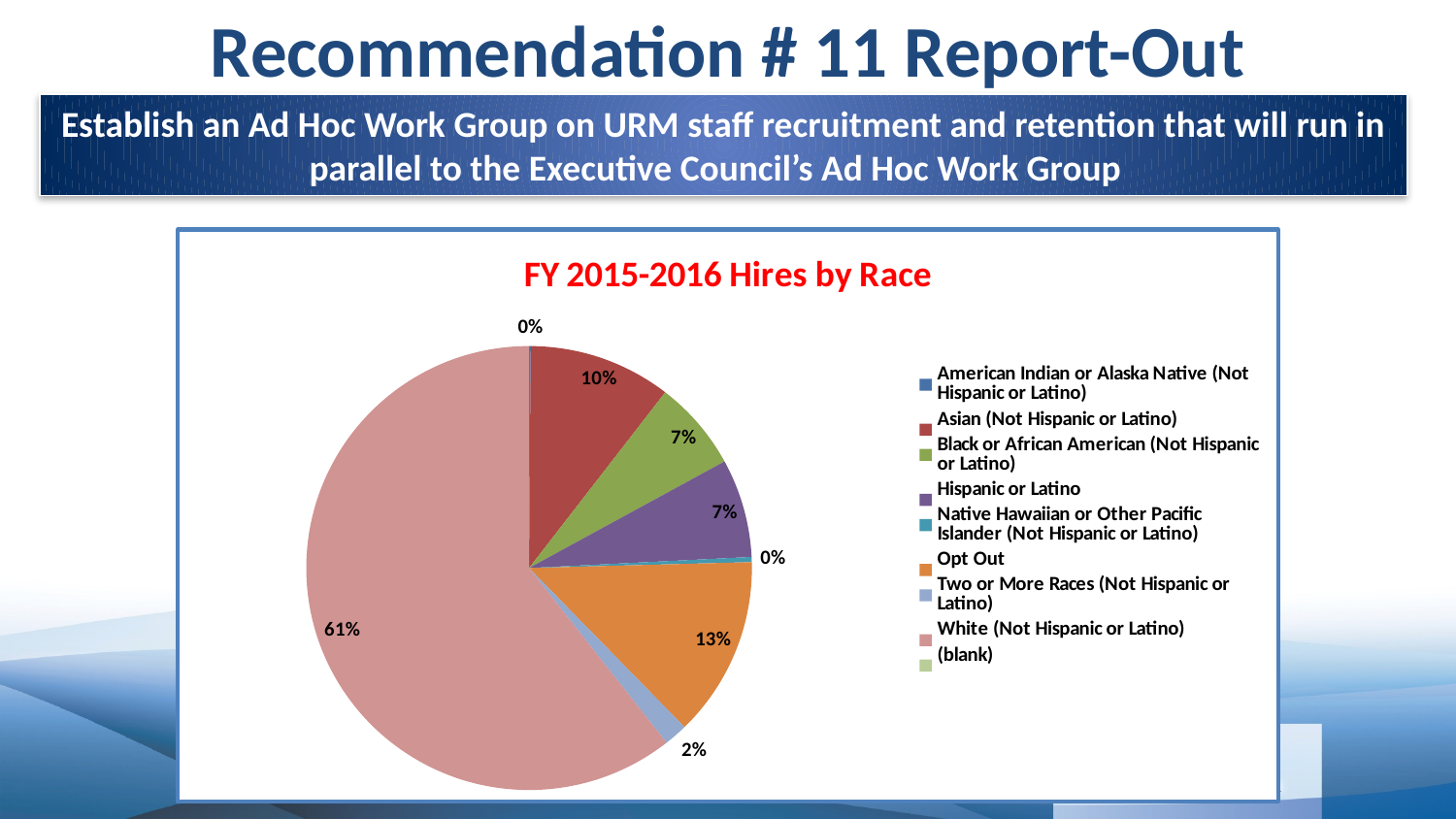
What kind of chart is shown on the slide? pie chart What is the title of the chart? FY 2015-2016 Hires by Race What percentage of hires is shown for Opt Out? 13% What is the difference in percentage points between the White (Not Hispanic or Latino) slice and the Opt Out slice? 48 percentage points Which category has the largest slice of the pie? White (Not Hispanic or Latino) What percentage of hires is shown for Asian (Not Hispanic or Latino)? 10% How many categories does the legend list? 9 What is the difference in percentage points between the Opt Out slice and the Asian (Not Hispanic or Latino) slice? 3 percentage points Which is larger, the Asian (Not Hispanic or Latino) slice or the Black or African American (Not Hispanic or Latino) slice? Asian (Not Hispanic or Latino) What share of FY 2015-2016 hires were White (Not Hispanic or Latino)? 61% What percentage of hires is shown for Two or More Races (Not Hispanic or Latino)? 2% What percentage of hires is shown for Black or African American (Not Hispanic or Latino)? 7%